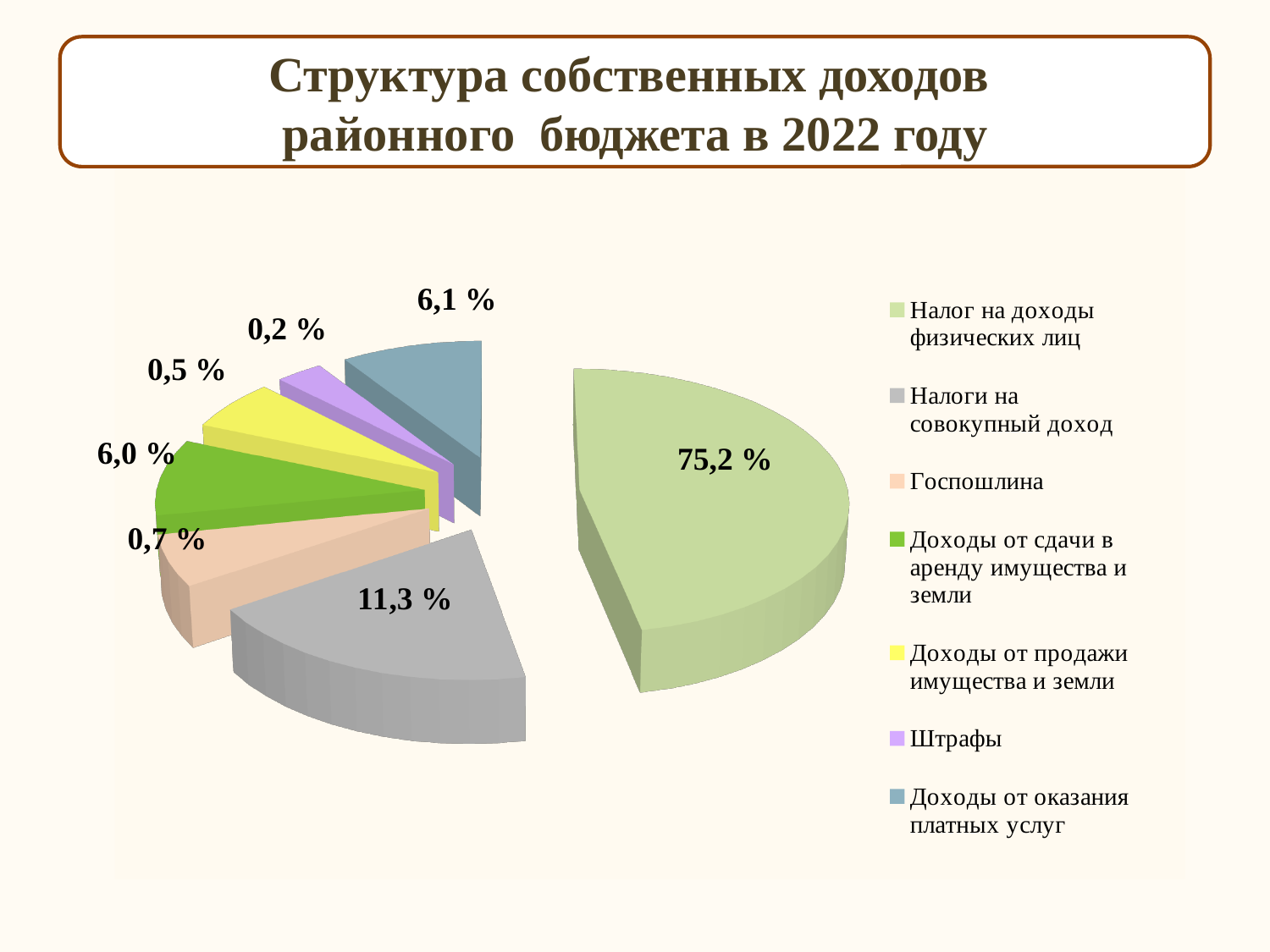
What share is shown for "Доходы от оказания платных услуг"? 6,1 % What share is shown for "Штрафы"? 0,2 % Which category has the largest share of own revenues? Налог на доходы физических лиц How many categories does the pie chart contain? 7 What share is shown for "Госпошлина"? 0,7 % What is the title of the slide? Структура собственных доходов районного бюджета в 2022 году Which is larger: the share of "Доходы от сдачи в аренду имущества и земли" or the share of "Госпошлина"? Доходы от сдачи в аренду имущества и земли What type of chart is shown on the slide? Pie chart Which category has the smallest share of own revenues? Штрафы By how many percentage points does the share of "Налог на доходы физических лиц" exceed the share of "Налоги на совокупный доход"? 63,9 % What share is shown for "Налоги на совокупный доход"? 11,3 % What share of own revenues does "Налог на доходы физических лиц" account for? 75,2 %